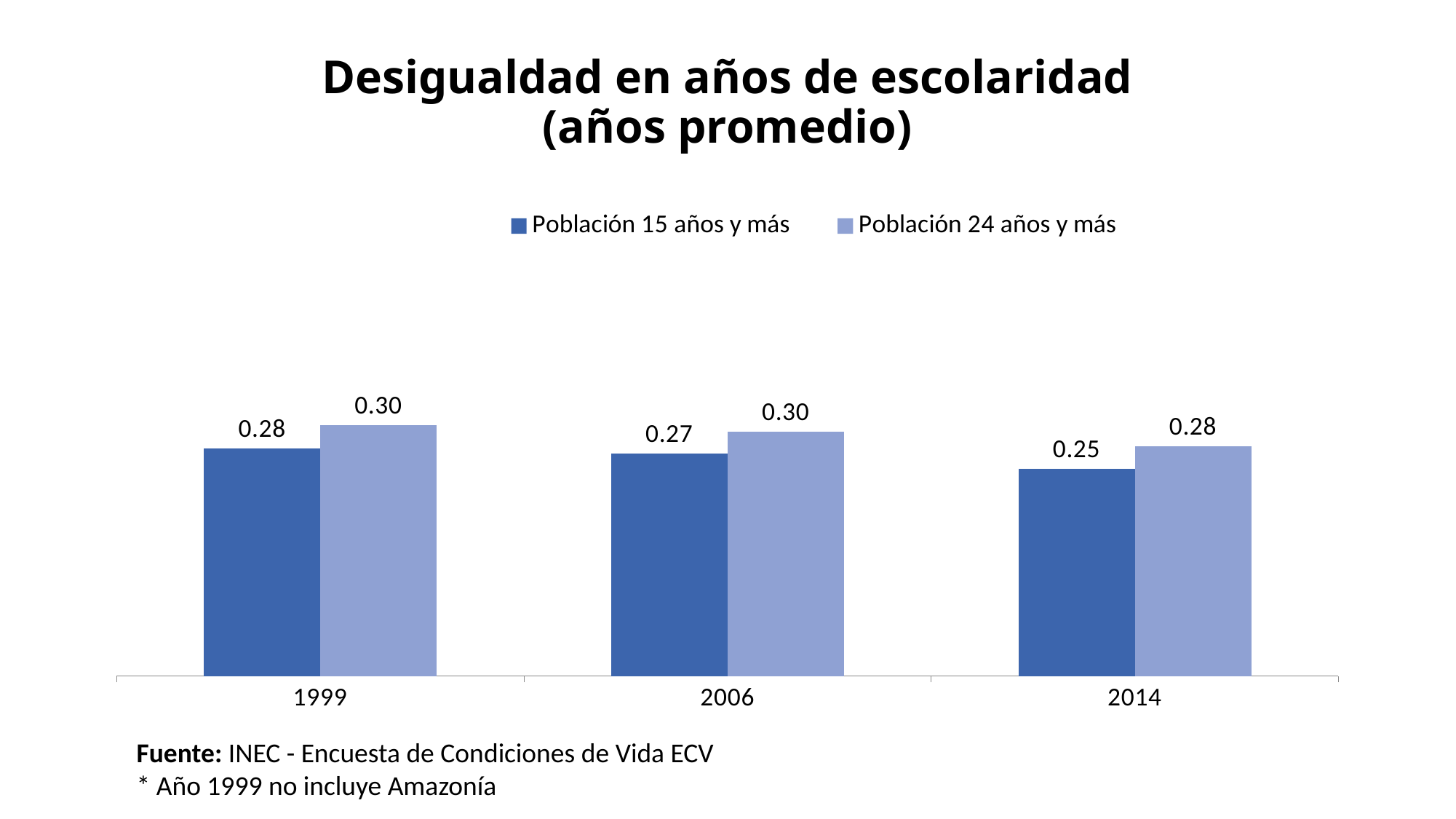
Which is larger in 2006: Población 15 años y más or Población 24 años y más? Población 24 años y más How many series does the legend list? 2 How many years are shown on the x axis? 3 What is the difference between Población 24 años y más and Población 15 años y más in 2014? 0.03 What is the value for Población 24 años y más in 2014? 0.28 What kind of chart is shown on the slide? Bar chart In which year is the value for Población 15 años y más highest? 1999 Do the values for Población 15 años y más rise or fall from 1999 to 2014? Fall What is the value for Población 15 años y más in 2014? 0.25 What is the value for Población 15 años y más in 1999? 0.28 What is the value for Población 24 años y más in 2006? 0.30 In which year is the value for Población 15 años y más lowest? 2014